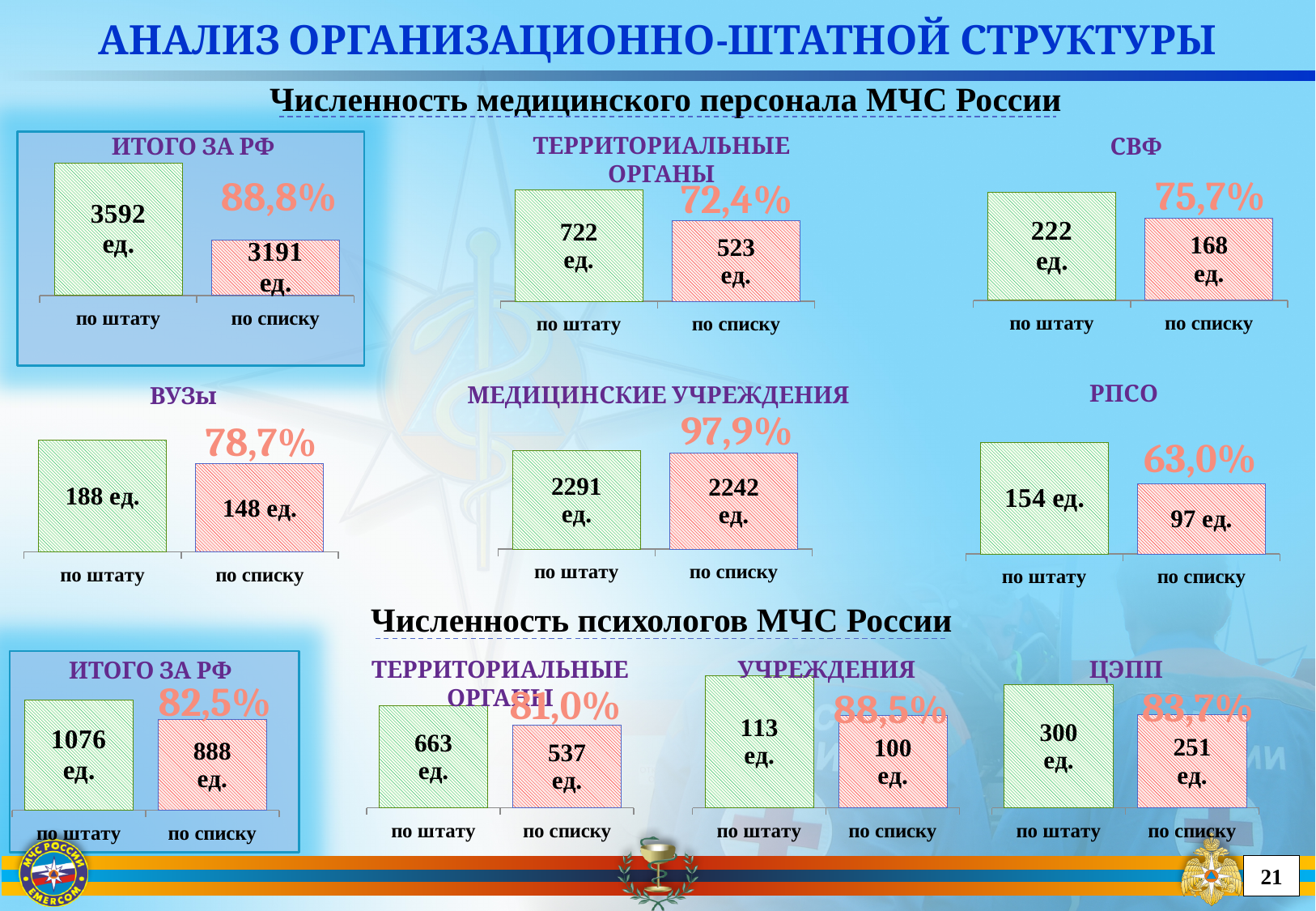
In the 'СВФ' chart, what is the value for 'по списку'? 168 ед. In the 'РПСО' chart, what is the difference between 'по штату' and 'по списку'? 57 ед. In the 'ИТОГО ЗА РФ' chart under 'Численность медицинского персонала МЧС России', what is the value for 'по списку'? 3191 ед. In the 'ЦЭПП' chart, what is the value for 'по штату'? 300 ед. In the 'ТЕРРИТОРИАЛЬНЫЕ ОРГАНЫ' chart under 'Численность медицинского персонала МЧС России', what is the difference between 'по штату' and 'по списку'? 199 ед. What type of chart is used for 'ТЕРРИТОРИАЛЬНЫЕ ОРГАНЫ' under 'Численность психологов МЧС России'? bar chart How many bars are shown in the 'УЧРЕЖДЕНИЯ' chart under 'Численность психологов МЧС России'? 2 In the 'ИТОГО ЗА РФ' chart under 'Численность психологов МЧС России', what is the value for 'по списку'? 888 ед. In the 'ИТОГО ЗА РФ' chart under 'Численность медицинского персонала МЧС России', what is the value for 'по штату'? 3592 ед. What percentage is printed above the 'РПСО' chart? 63,0% In the 'ВУЗы' chart, which bar is taller, 'по штату' or 'по списку'? по штату In the 'МЕДИЦИНСКИЕ УЧРЕЖДЕНИЯ' chart, what is the value for 'по штату'? 2291 ед.